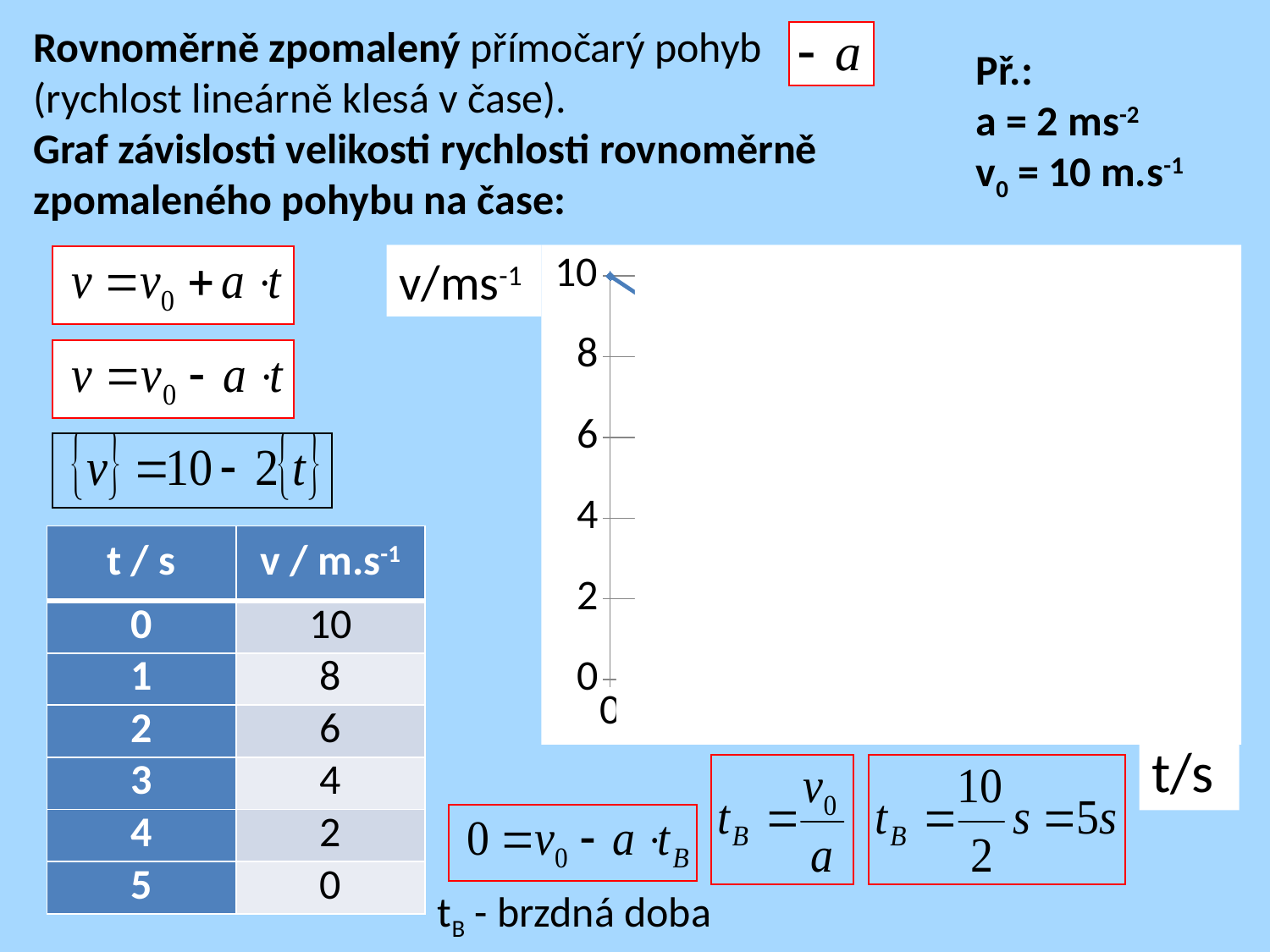
What is the label of the horizontal axis of the chart? t/s Is the value of v at t = 0 greater or less than 8? greater What kind of chart is shown on the slide? line chart What is the value of v at t = 0 on the chart? 10 Does the plotted line rise or fall as t increases? fall What is the label of the vertical axis of the chart? v/ms-1